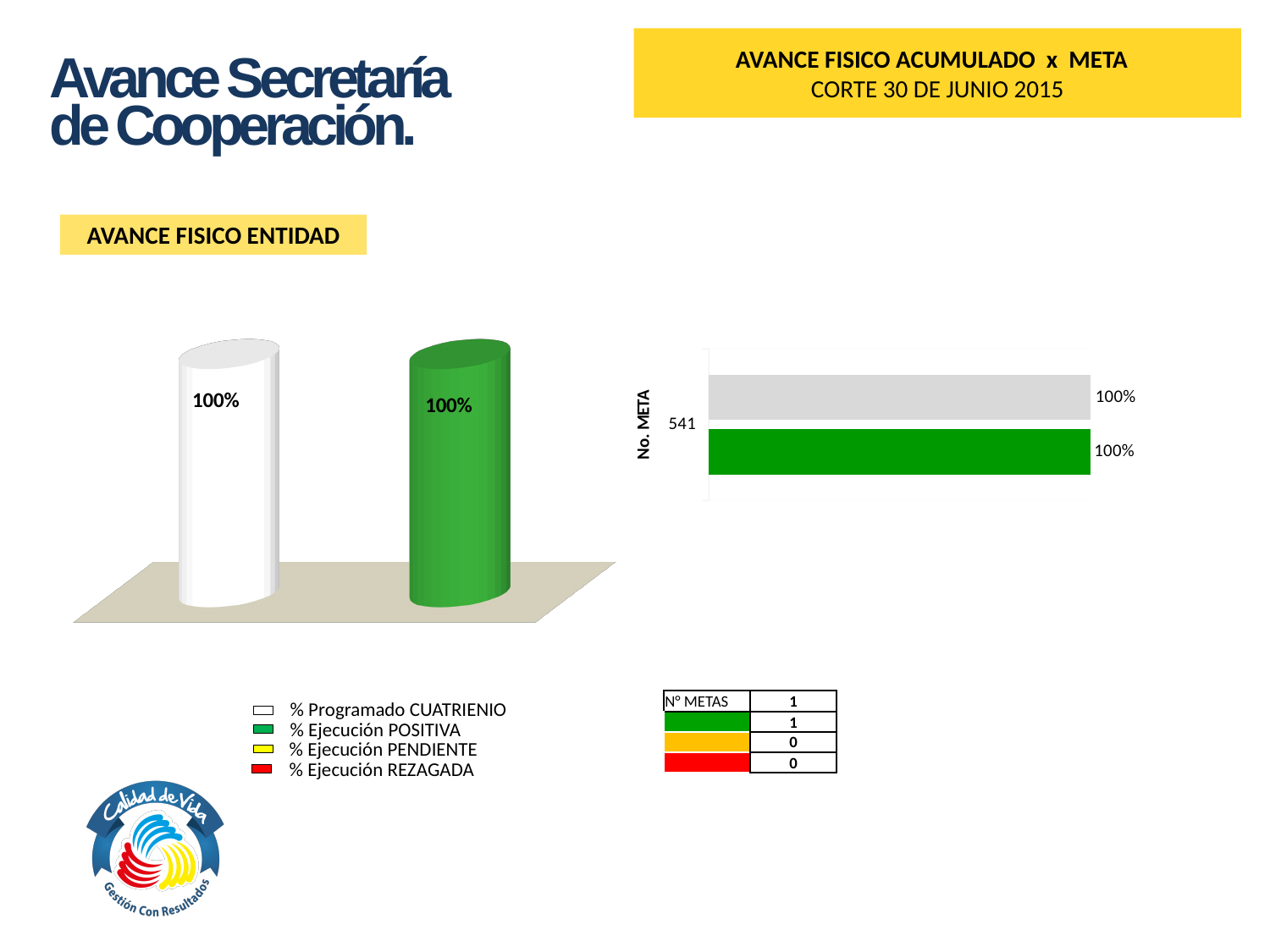
In the AVANCE FISICO ENTIDAD chart, what value is shown on the white bar? 100% How many entries does the legend at the bottom of the slide list? 4 What is the axis title on the vertical axis of the AVANCE FISICO ACUMULADO x META chart? No. META What kind of chart is the AVANCE FISICO ENTIDAD chart? Bar chart In the AVANCE FISICO ACUMULADO x META chart, what value is shown for the green bar of meta 541? 100% In the AVANCE FISICO ENTIDAD chart, what is the difference between the white bar and the green bar? 0% In the AVANCE FISICO ACUMULADO x META chart, what value is shown for the grey bar of meta 541? 100% How many categories are shown in the AVANCE FISICO ACUMULADO x META chart? 1 What kind of chart is the AVANCE FISICO ACUMULADO x META chart? Bar chart How many bars are plotted in the AVANCE FISICO ENTIDAD chart? 2 In the AVANCE FISICO ACUMULADO x META chart, what is the label of the only category on the vertical axis? 541 In the AVANCE FISICO ENTIDAD chart, what value is shown on the green bar? 100%